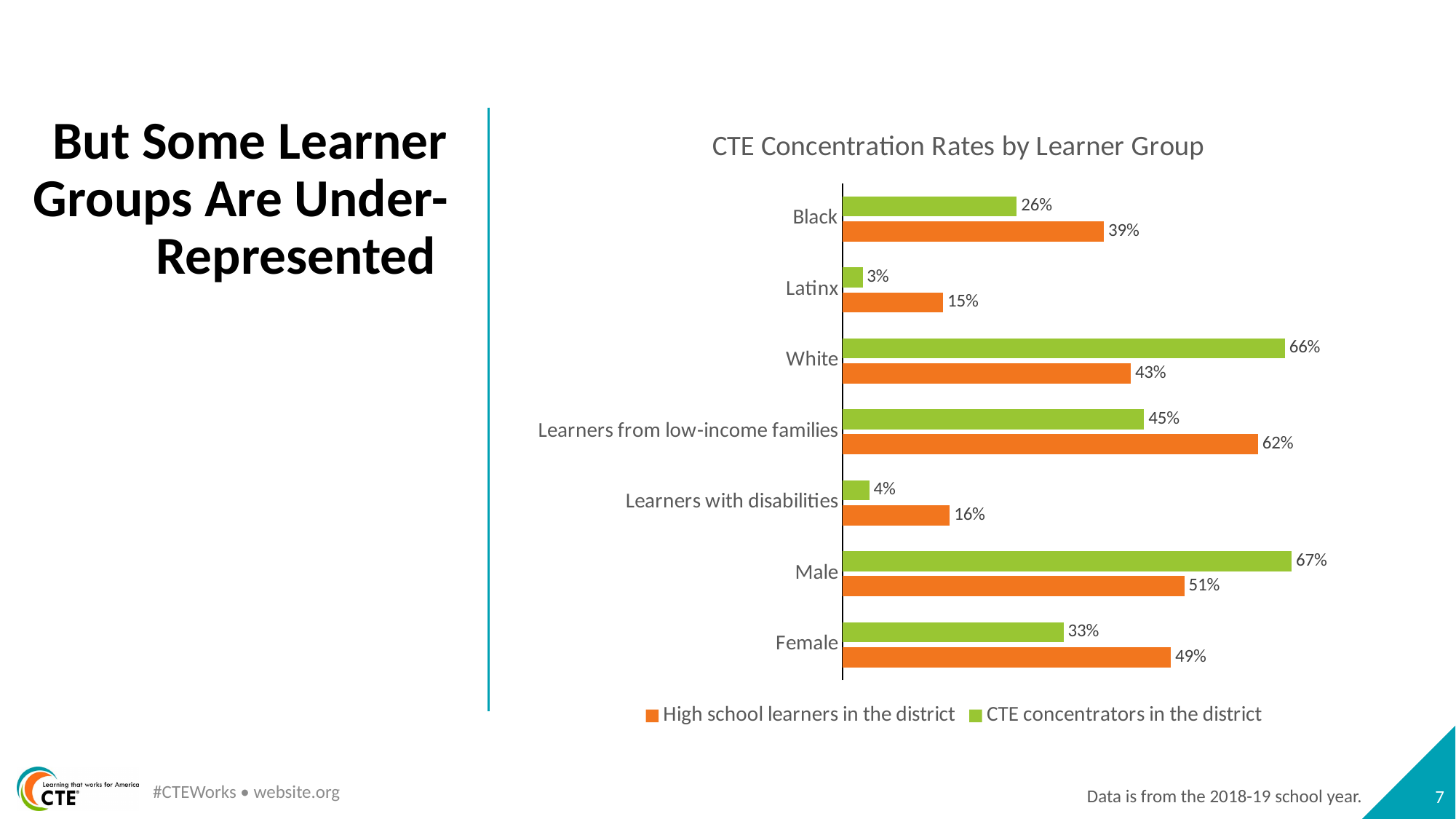
For Female, which is larger: the High school learners in the district value or the CTE concentrators in the district value? High school learners in the district How many series does the legend list? 2 Which learner group has the lowest value in the High school learners in the district series? Latinx How many learner groups are shown on the chart? 7 What is the difference between the High school learners in the district value and the CTE concentrators in the district value for White? 23% Which colour represents the CTE concentrators in the district series? Green What is the title of the chart? CTE Concentration Rates by Learner Group What kind of chart is shown on the slide? Bar chart What is the value for Latinx in the CTE concentrators in the district series? 3% Which learner group has the highest value in the CTE concentrators in the district series? Male What is the value for Learners from low-income families in the High school learners in the district series? 62% What is the value for Black in the CTE concentrators in the district series? 26%